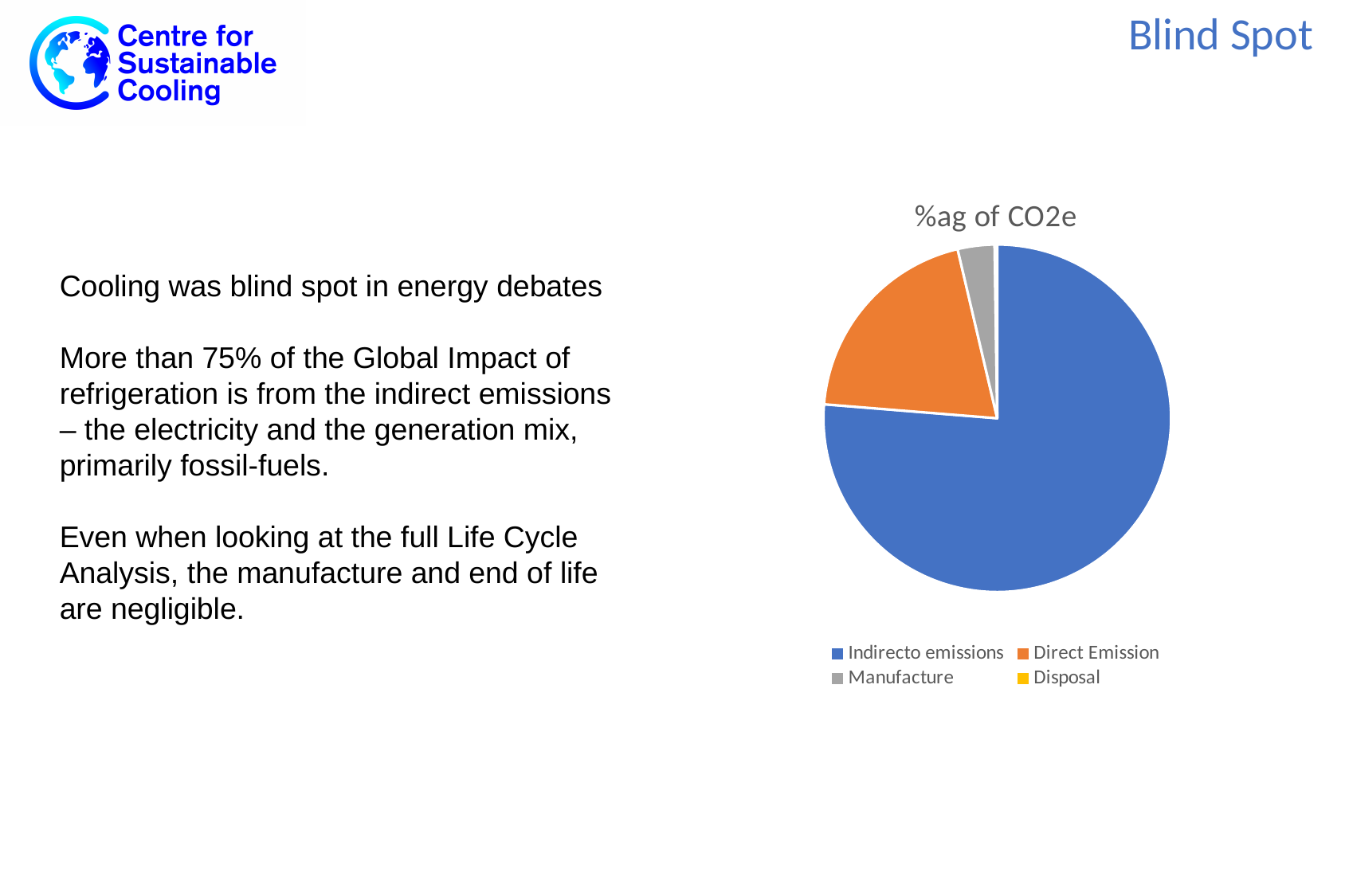
Which is larger in the pie chart, Direct Emission or Manufacture? Direct Emission Which is larger in the pie chart, Indirecto emissions or Manufacture? Indirecto emissions Does the Indirecto emissions slice take up more or less than half of the pie chart? more Which category has the second-largest slice of the pie chart? Direct Emission Which is larger in the pie chart, Indirecto emissions or Direct Emission? Indirecto emissions What is the title of the pie chart? %ag of CO2e How many categories does the legend of the pie chart list? 4 What kind of chart is shown on the slide? pie chart Which category has the largest slice of the pie chart? Indirecto emissions What colour is the Indirecto emissions slice in the pie chart? blue